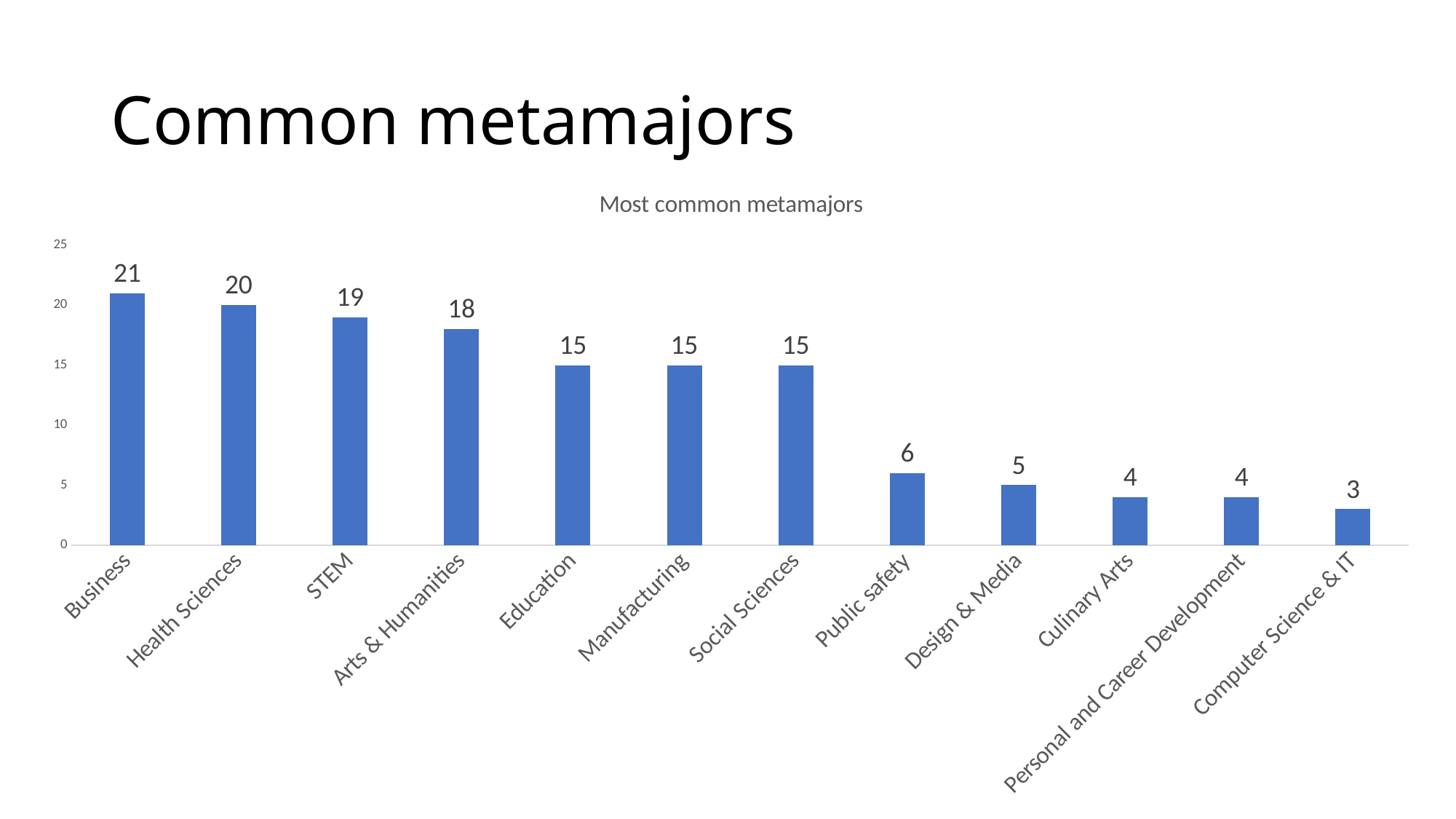
What is the difference between the values for Business and STEM? 2 How many categories are shown in the chart? 12 What is the title of the chart? Most common metamajors What kind of chart is shown on the slide? Bar chart What is the difference between the values for Health Sciences and Public safety? 14 What is the value for Arts & Humanities? 18 Which is larger, the value for Education or the value for Culinary Arts? Education What is the value for Design & Media? 5 What is the value for Business? 21 Is the value for Social Sciences greater or less than 10? greater Which category has the highest value? Business Which category has the lowest value? Computer Science & IT